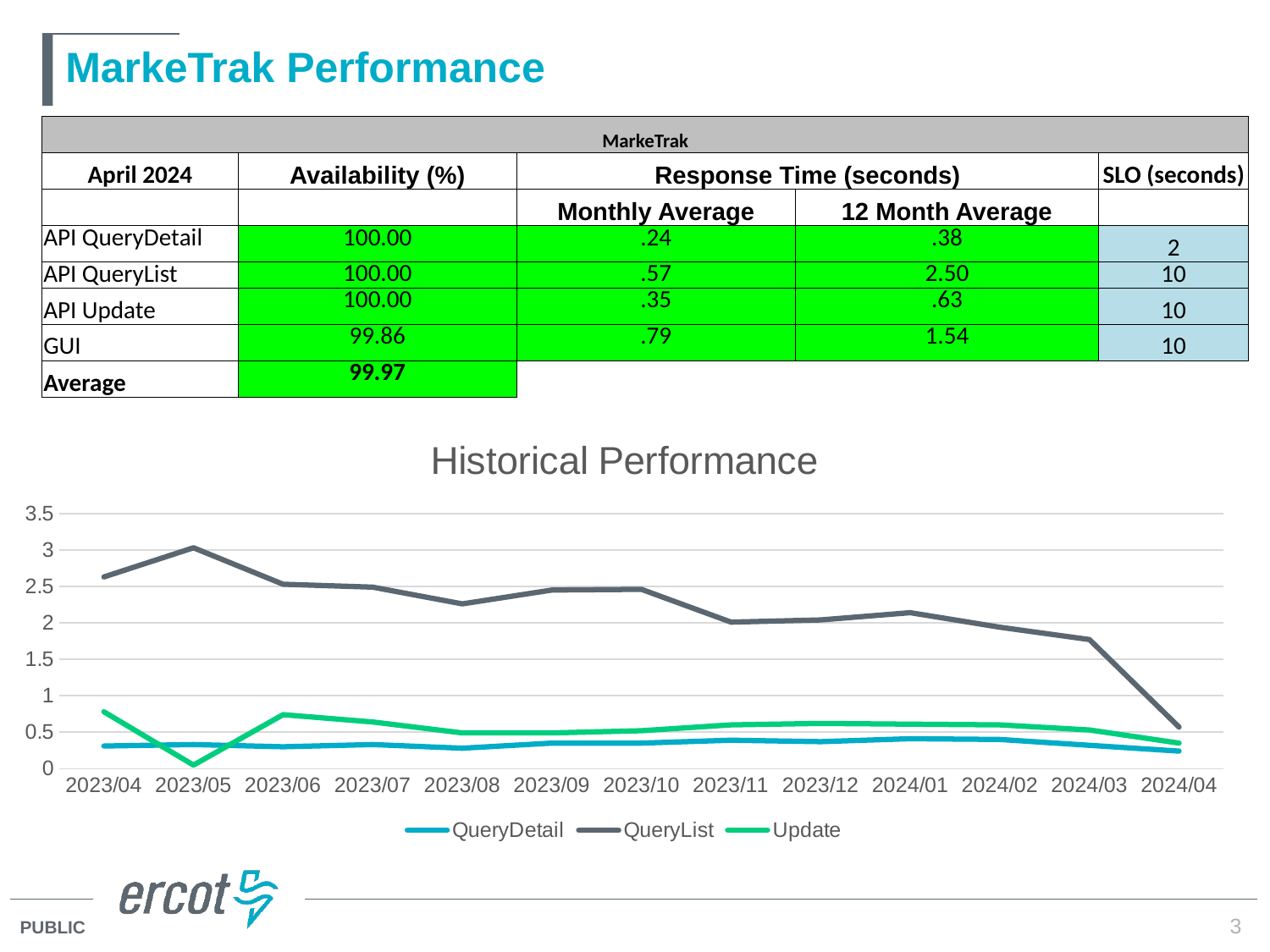
In the Historical Performance chart, which is larger at 2023/06: the Update value or the QueryDetail value? Update In which month does the QueryList series reach its lowest value in the Historical Performance chart? 2024/04 In which month does the QueryList series reach its highest value in the Historical Performance chart? 2023/05 What is the title of the line chart on the slide? Historical Performance Which series in the Historical Performance chart has the highest values throughout the period? QueryList In the Historical Performance chart, does the QueryList series rise or fall from 2024/01 to 2024/04? fall In the Historical Performance chart, is the Update value for 2023/05 greater or less than 0.5? less In the Historical Performance chart, is the QueryList value for 2024/03 greater or less than 1.5? greater How many series does the legend of the Historical Performance chart list? 3 How many months are plotted along the x axis of the Historical Performance chart? 13 What kind of chart is the Historical Performance chart? line chart In the Historical Performance chart, is the QueryList value for 2023/04 greater or less than 2.5? greater